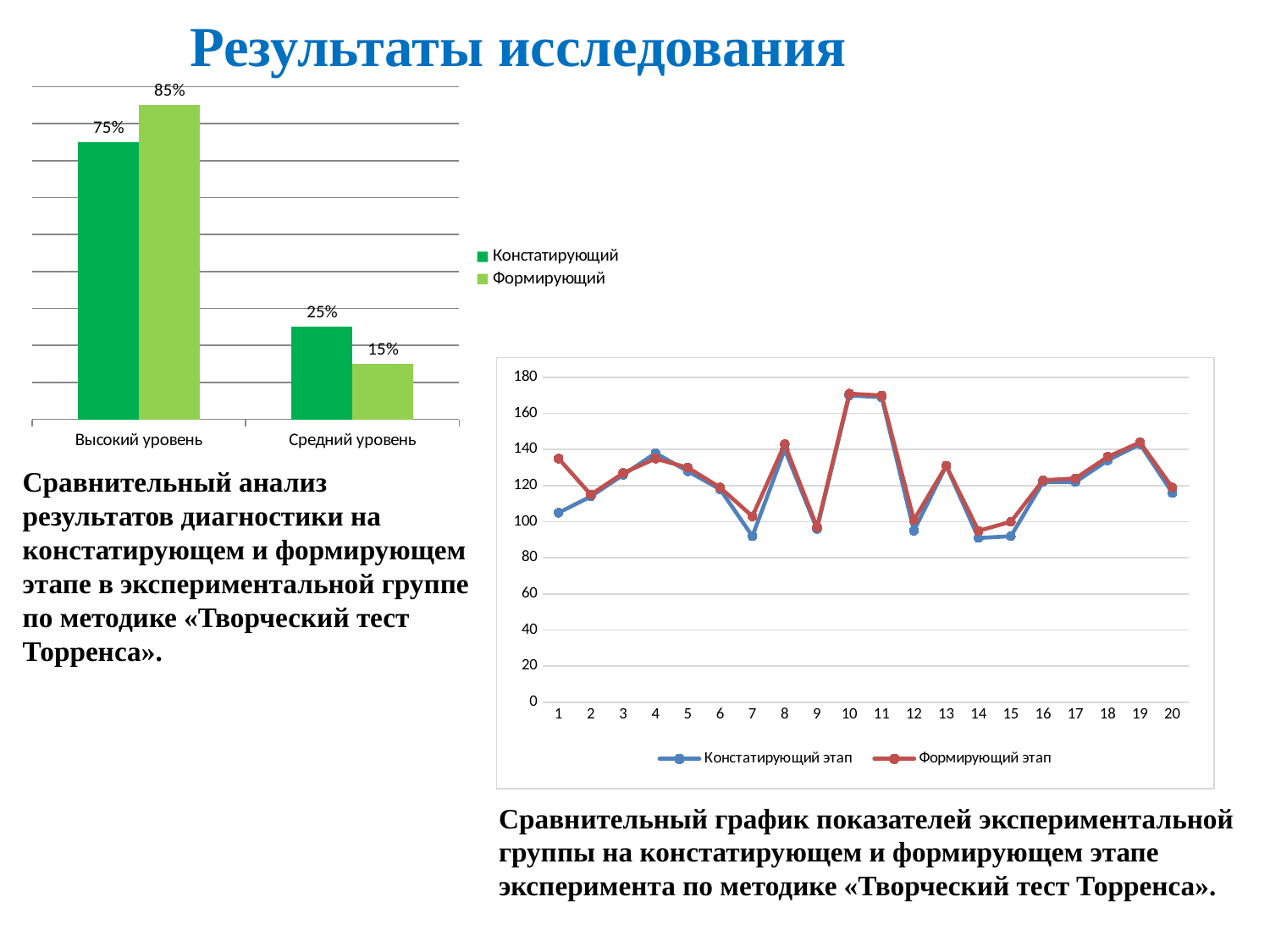
In the line chart on the right, is the value for Формирующий этап at point 10 greater or less than 160? greater What kind of chart is the chart on the left? Bar chart In the line chart on the right, how many points are on the x axis? 20 In the bar chart on the left, what is the value for Формирующий at Средний уровень? 15% In the bar chart on the left, which bar is the highest? Формирующий at Высокий уровень (85%) In the line chart on the right, what are the two series listed in the legend? Констатирующий этап and Формирующий этап In the bar chart on the left, what is the difference between the Формирующий and Констатирующий values at Высокий уровень? 10% In the bar chart on the left, how many series does the legend list? 2 In the bar chart on the left, which series has the larger value at Средний уровень? Констатирующий In the bar chart on the left, what is the value for Констатирующий at Высокий уровень? 75% What kind of chart is the chart on the right? Line chart In the line chart on the right, is the value for Констатирующий этап at point 7 greater or less than 100? less